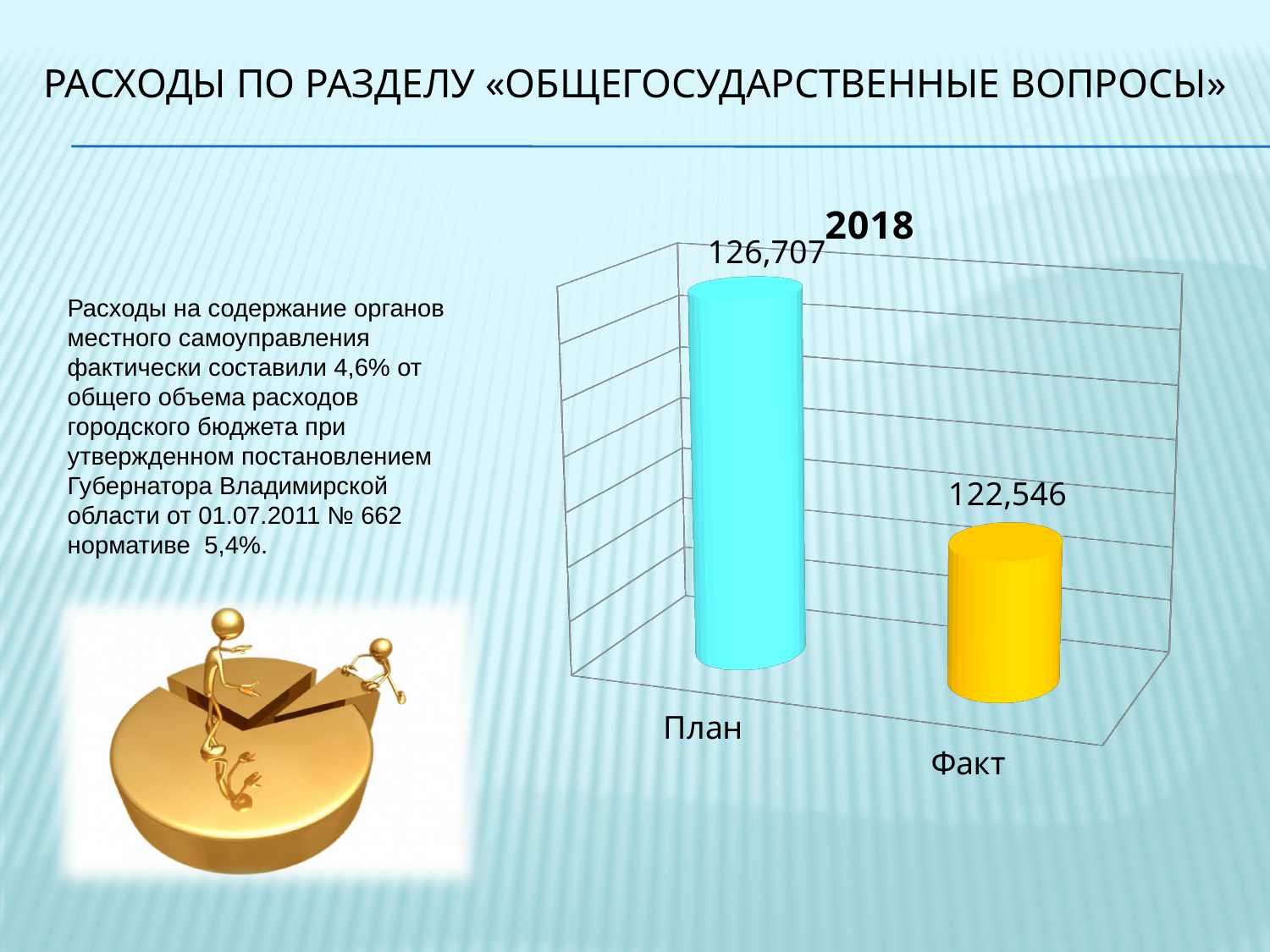
What is the value for План in the chart? 126,707 Do the values rise or fall from План to Факт? fall What kind of chart is shown on the slide? bar chart What is the value for Факт in the chart? 122,546 Which category has the higher value, План or Факт? План Which category has the lowest value in the chart? Факт What is the title of the chart? 2018 Is the value for Факт larger or smaller than the value for План? smaller What colour is the bar for Факт? yellow How many categories are shown in the chart? 2 What is the difference between the План and Факт values? 4,161